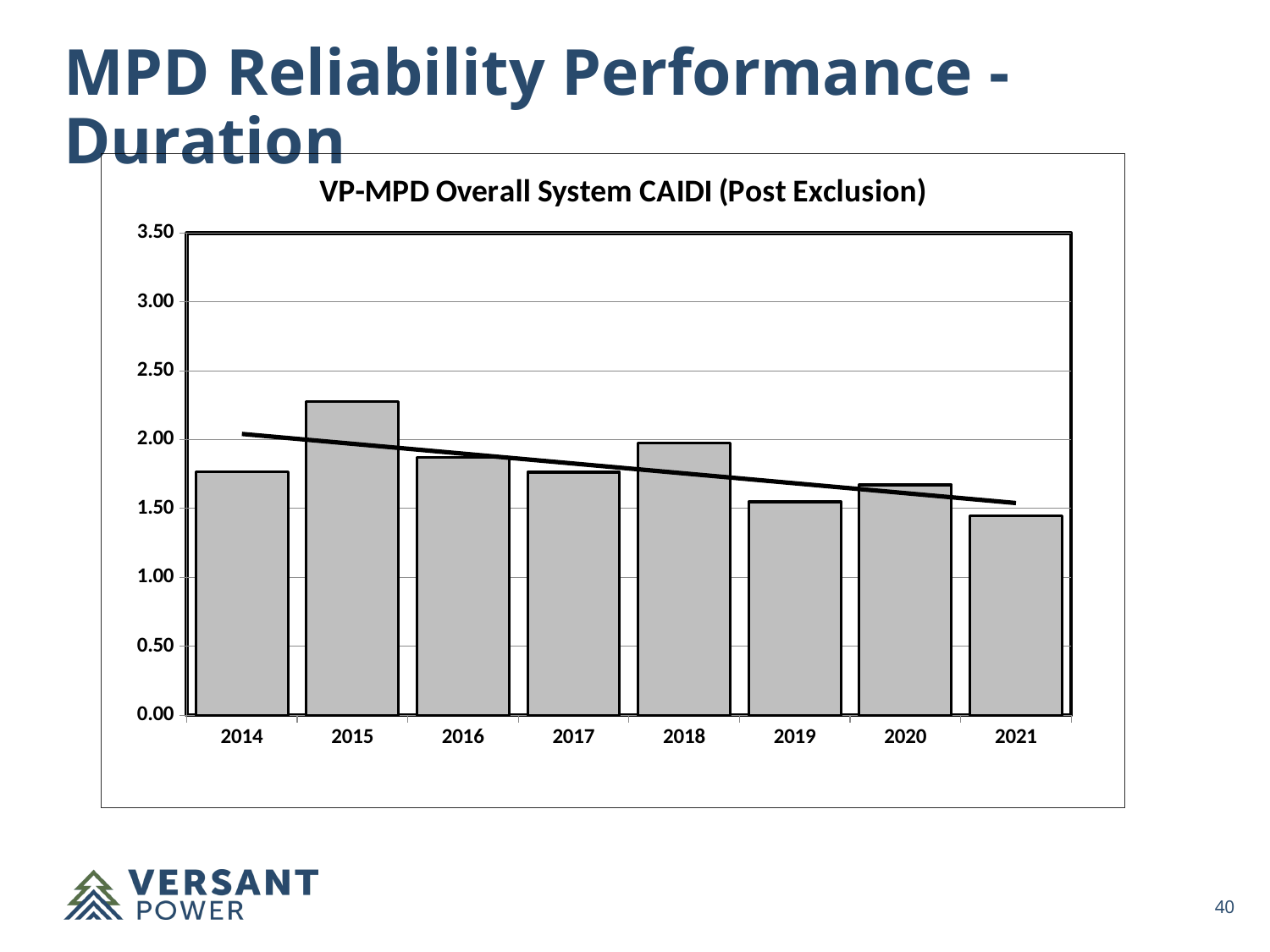
What is the title of the chart? VP-MPD Overall System CAIDI (Post Exclusion) Is the value for 2021 greater or less than 1.50? less Which year has the lowest CAIDI value? 2021 Which year has the highest CAIDI value? 2015 What is the highest value shown on the y axis of the chart? 3.50 Is the value for 2019 greater or less than 2.00? less Which is larger, the value for 2015 or the value for 2019? 2015 Is the value for 2015 greater or less than 2.00? greater Does the trend line drawn across the bars rise or fall from 2014 to 2021? fall What kind of chart is shown on the slide? bar chart How many years are shown on the x axis of the chart? 8